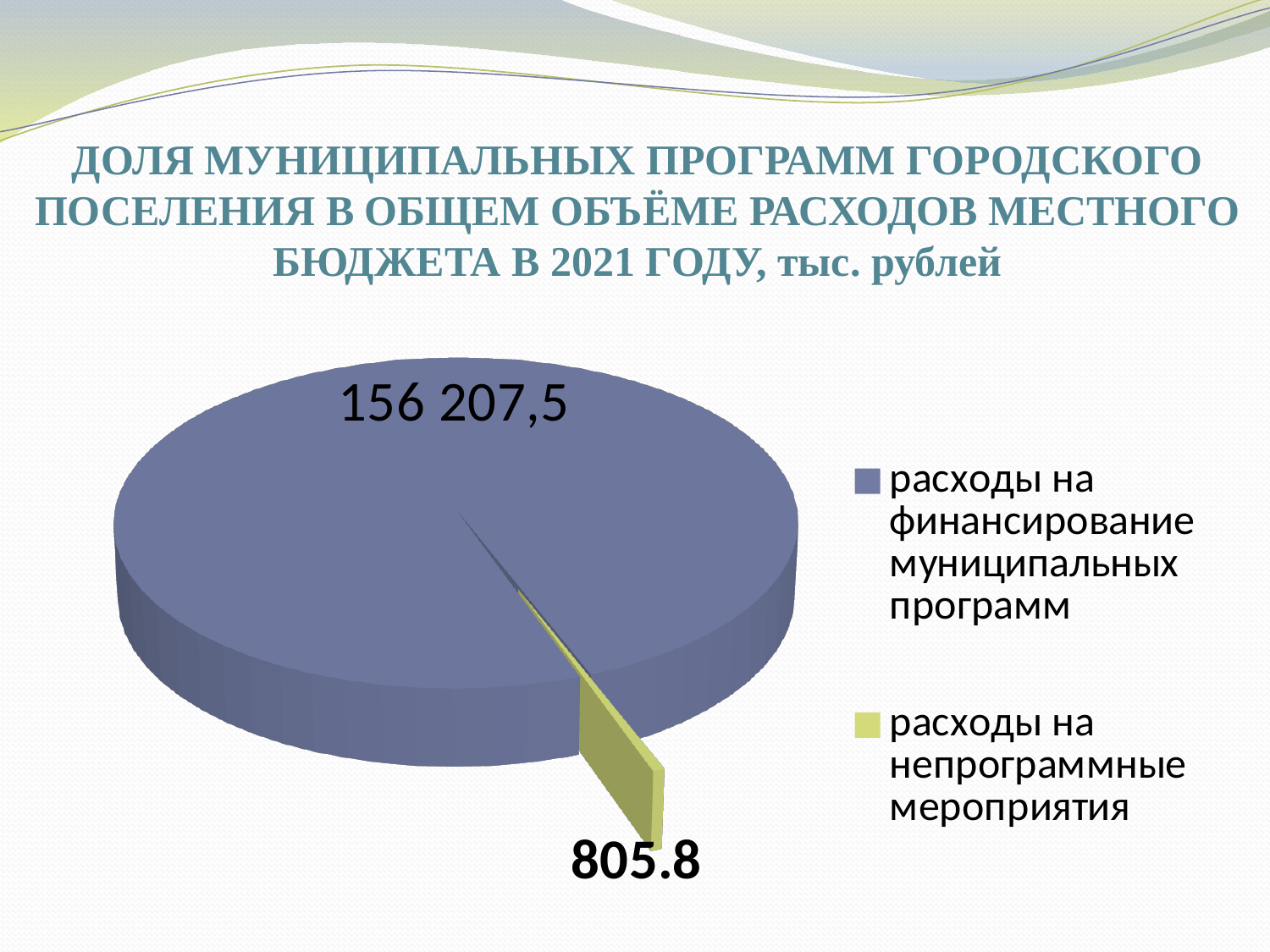
What unit of measurement is stated in the chart title? тыс. рублей What type of chart is shown on the slide? pie chart Which category has the smallest slice of the pie? расходы на непрограммные мероприятия What is the total of the two values shown in the pie chart? 157 013,3 Which category has the largest slice of the pie? расходы на финансирование муниципальных программ Which is larger: the value for "расходы на финансирование муниципальных программ" or the value for "расходы на непрограммные мероприятия"? расходы на финансирование муниципальных программ How many entries does the legend list? 2 What is the value for "расходы на непрограммные мероприятия"? 805.8 How many slices does the pie chart have? 2 What is the difference between the value for "расходы на финансирование муниципальных программ" and the value for "расходы на непрограммные мероприятия"? 155 401,7 What colour is the slice for "расходы на непрограммные мероприятия"? yellow-green What is the value for "расходы на финансирование муниципальных программ"? 156 207,5